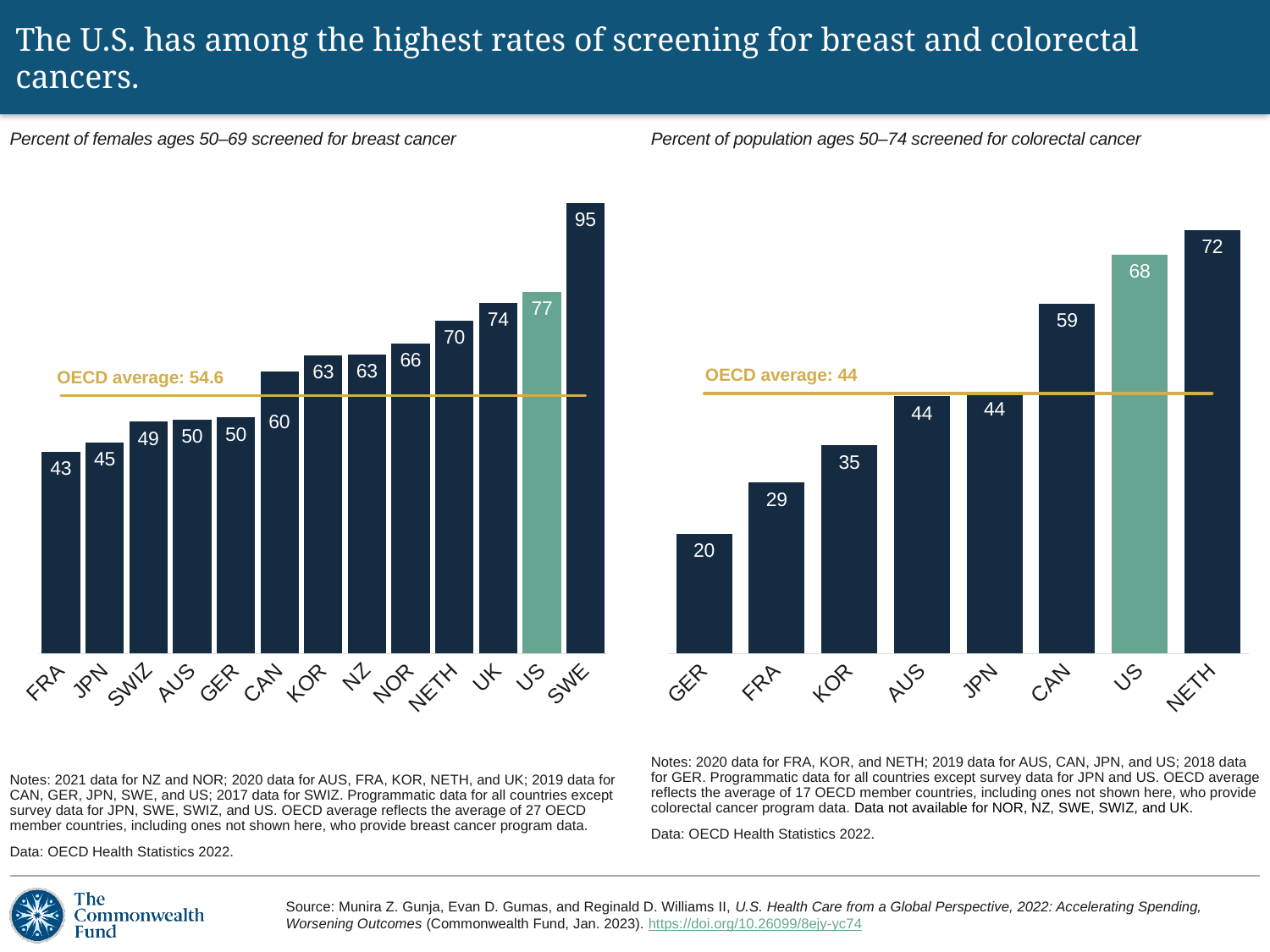
In the breast cancer screening chart, which country has the highest value? SWE In the colorectal cancer screening chart, what is the value for CAN? 59 In the breast cancer screening chart, what is the value for the US? 77 In the colorectal cancer screening chart, what is the difference between NETH and GER? 52 What OECD average is shown on the breast cancer screening chart? 54.6 How many countries are shown in the colorectal cancer screening chart? 8 In the breast cancer screening chart, do the values rise or fall from left to right? Rise How many countries are shown in the breast cancer screening chart? 13 In the colorectal cancer screening chart, which country has the lowest value? GER In the breast cancer screening chart, what is the difference between SWE and the US? 18 What kind of chart is the colorectal cancer screening chart? Bar chart In the colorectal cancer screening chart, which is larger, the value for KOR or the value for FRA? KOR